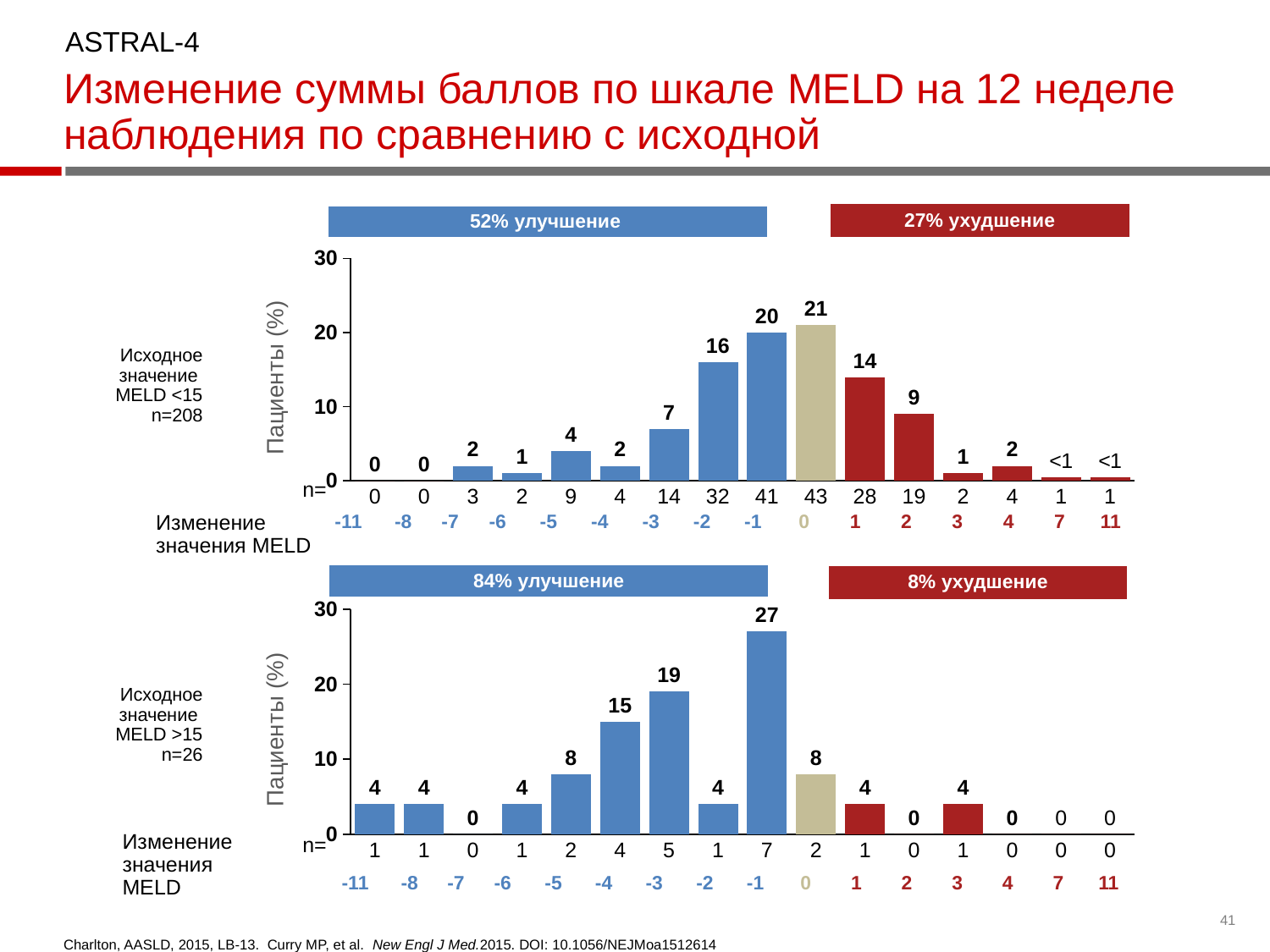
In the bottom chart (baseline MELD >15), what percentage of patients had a MELD change of -3? 19 How many MELD change categories are shown on the x axis of the top chart? 16 What type of chart is used on this slide? Bar chart In the top chart (baseline MELD <15), what is the difference in percentage between the MELD change of -2 and the MELD change of 1? 2 In the top chart (baseline MELD <15), what percentage of patients had a MELD change of 2? 9 In the bottom chart (baseline MELD >15), which MELD change category has the highest percentage of patients? -1 In the bottom chart (baseline MELD >15), which is larger: the percentage for a MELD change of -5 or for a MELD change of 1? -5 In the top chart (baseline MELD <15), what percentage of patients had a MELD change of -1? 20 In the top chart (baseline MELD <15), what is the n value for a MELD change of 0? 43 In the bottom chart (baseline MELD >15), what is the difference in percentage between the MELD change of -1 and the MELD change of -4? 12 In the top chart (baseline MELD <15), which MELD change category has the highest percentage of patients? 0 What percentage of patients with baseline MELD >15 showed improvement, according to the label above the bottom chart? 84%